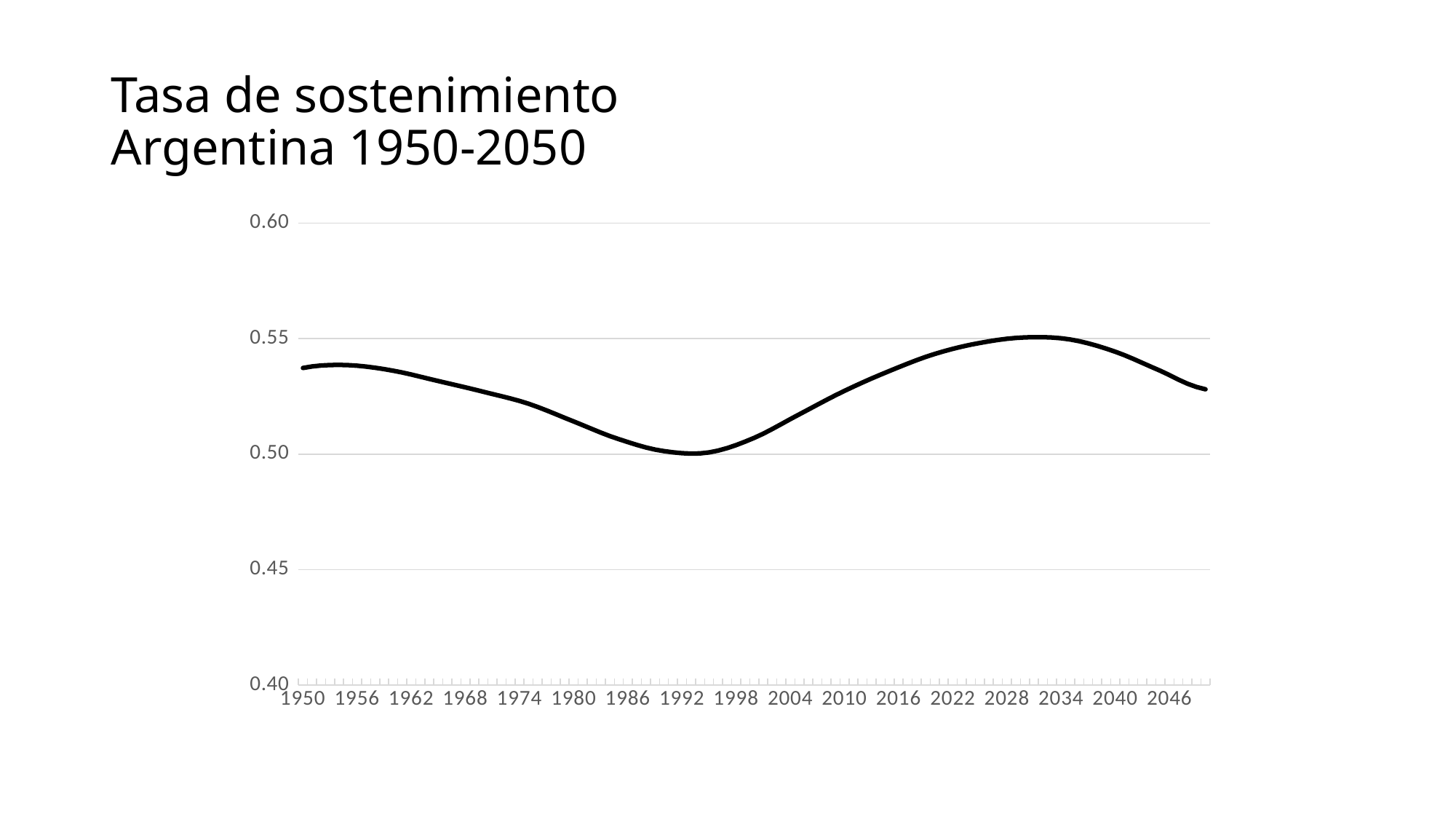
Is the value for 1950 greater or less than 0.55? less Which year has the larger value, 1992 or 2028? 2028 What is the title of the chart? Tasa de sostenimiento Argentina 1950-2050 Does the line rise or fall between 2034 and 2046? fall Which year has the larger value, 1950 or 1992? 1950 Does the line rise or fall between 1992 and 2028? rise Does the line rise or fall between 1950 and 1992? fall Is the value for 2028 greater or less than 0.50? greater Is the value for 2046 greater or less than 0.50? greater How many lines (series) are plotted on the chart? 1 What kind of chart is shown on the slide? line chart